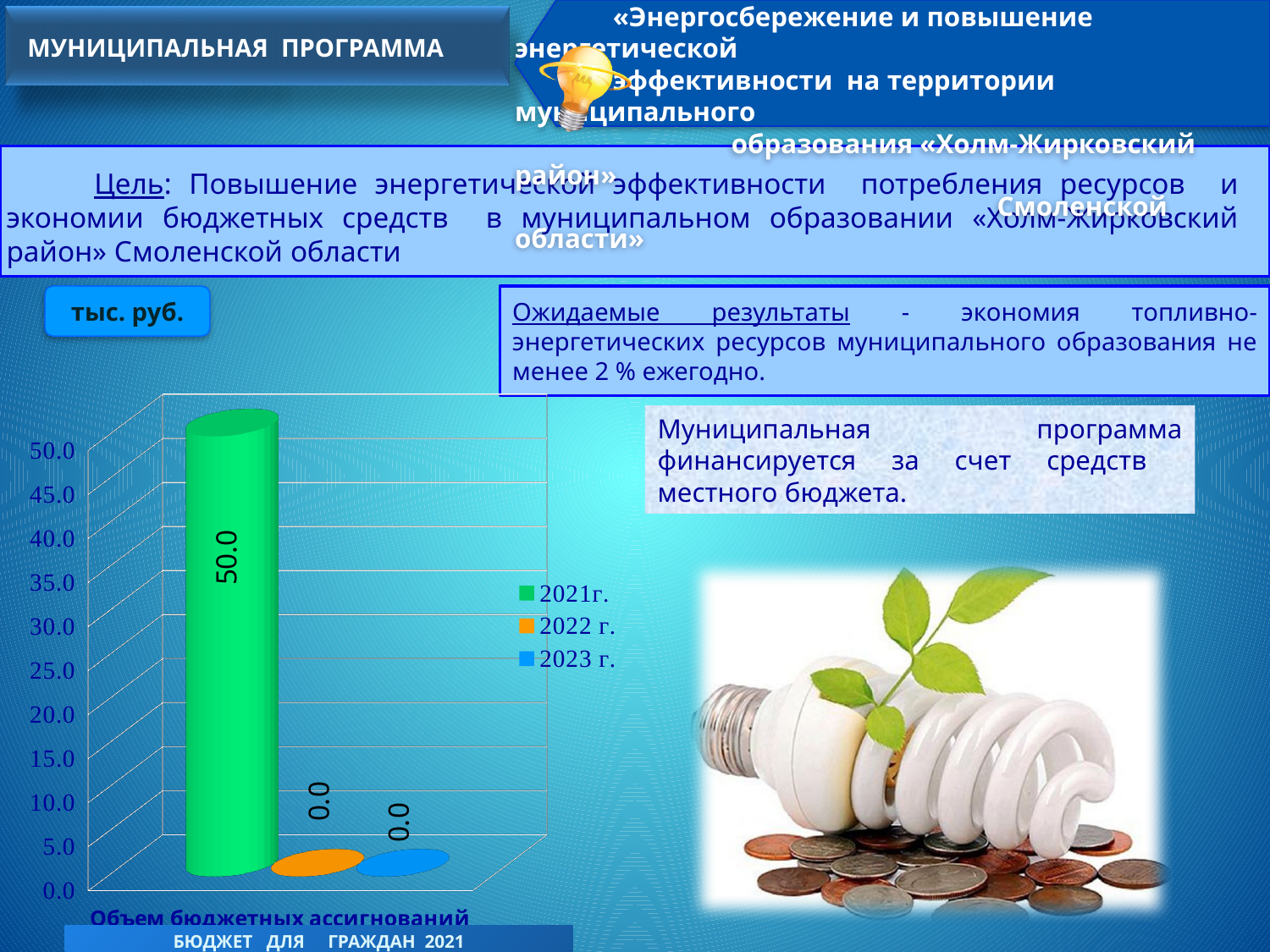
What is the value for 2023 г. in the chart? 0.0 What is the value for 2021г. in the chart? 50.0 What is the highest value shown on the chart's vertical axis? 50.0 Which is larger, the value for 2021г. or the value for 2023 г.? 2021г. Which series has the highest value in the chart? 2021г. What is the difference between the values for 2021г. and 2022 г.? 50.0 What is the value for 2022 г. in the chart? 0.0 What kind of chart is shown on the slide? bar chart What is the category label shown below the chart? Объем бюджетных ассигнований What unit is indicated for the chart values? тыс. руб. How many series does the chart legend list? 3 Is the value for 2021г. greater or less than 45.0? greater